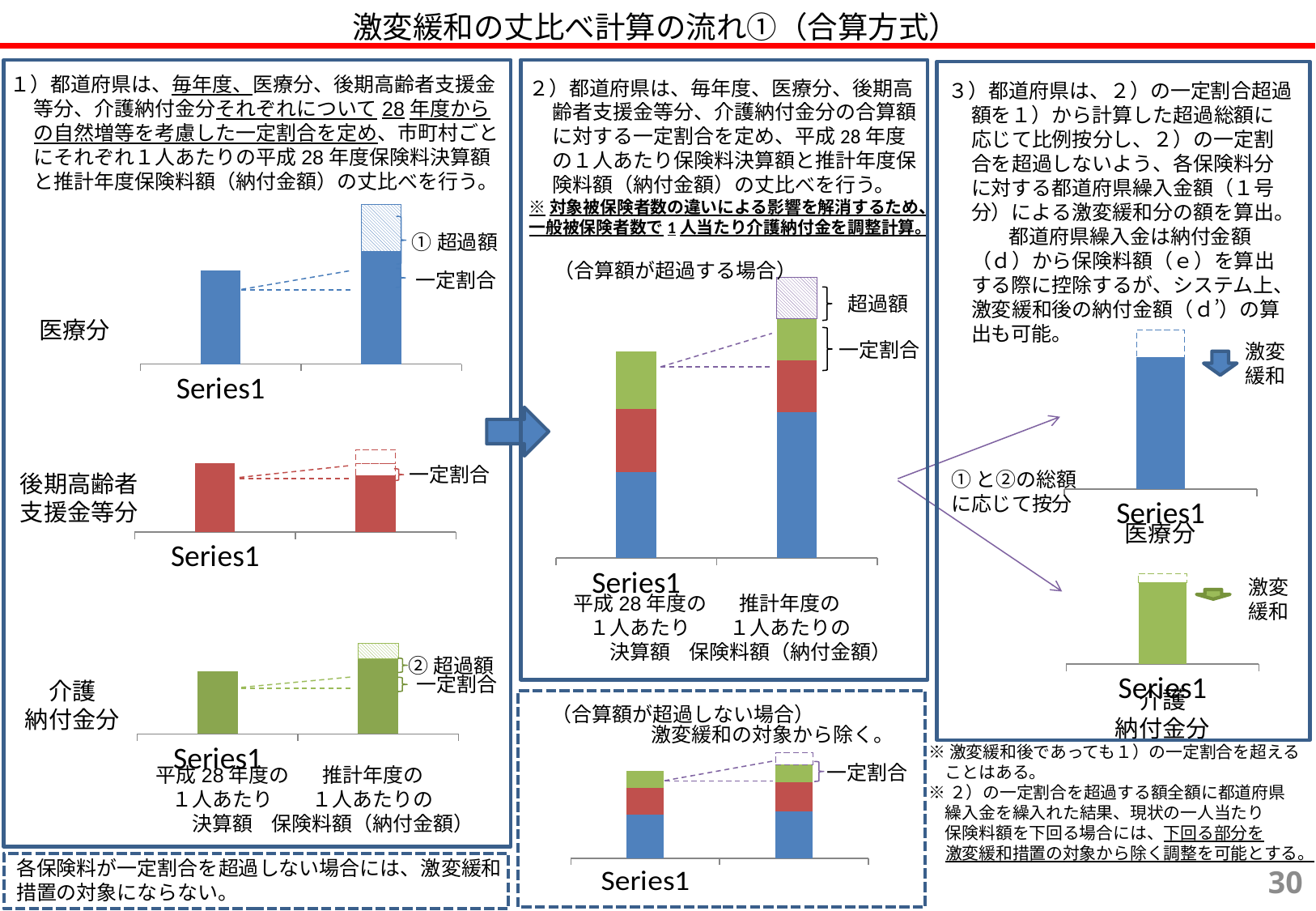
In the 医療分 chart in the left panel, which bar is taller, the left bar (平成28年度の1人あたり決算額) or the right bar (推計年度の1人あたりの保険料額)? the right bar What kind of chart is the 介護納付金分 chart in the left panel? bar chart In the 医療分 chart in the left panel, how many bars are plotted? 2 In the 介護納付金分 chart in the left panel, how many bars are plotted? 2 In the middle chart labelled 合算額が超過する場合, do the bar heights rise or fall from left to right? rise In the middle chart labelled 合算額が超過する場合, which stacked bar is taller, the left one or the right one? the right one In the middle chart labelled 合算額が超過する場合, how many coloured segments make up the left stacked bar? 3 In the 後期高齢者支援金等分 chart in the left panel, what colour are the bars? red What kind of chart is the 合算額が超過しない場合 chart at the bottom of the middle panel? bar chart In the 医療分 chart in the left panel, what colour are the solid bars? blue What kind of chart is the 医療分 chart in the left panel? bar chart